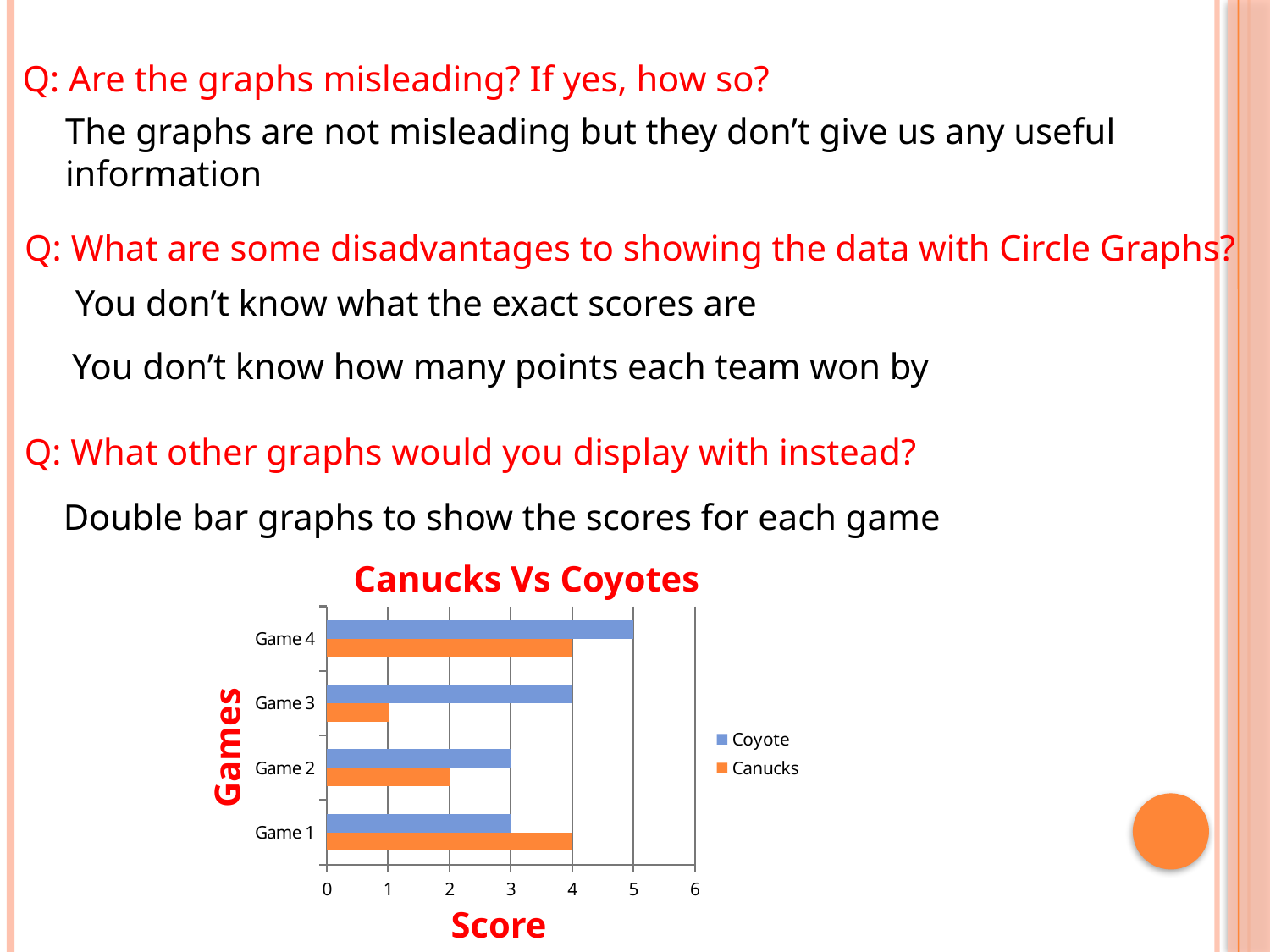
What is the title of the chart? Canucks Vs Coyotes What is the Coyote score for Game 4? 5 What is the difference between the Coyote and Canucks scores in Game 3? 3 Is the Coyote score for Game 2 greater or less than 4? less How many series does the chart's legend list? 2 How many games are shown on the chart? 4 In which game did the Coyote series have its highest score? Game 4 What kind of chart is shown on the slide? Bar chart In which game did the Canucks have their lowest score? Game 3 What is the Canucks score for Game 3? 1 What is the Canucks score for Game 1? 4 In Game 1, which team has the higher score, Coyote or Canucks? Canucks